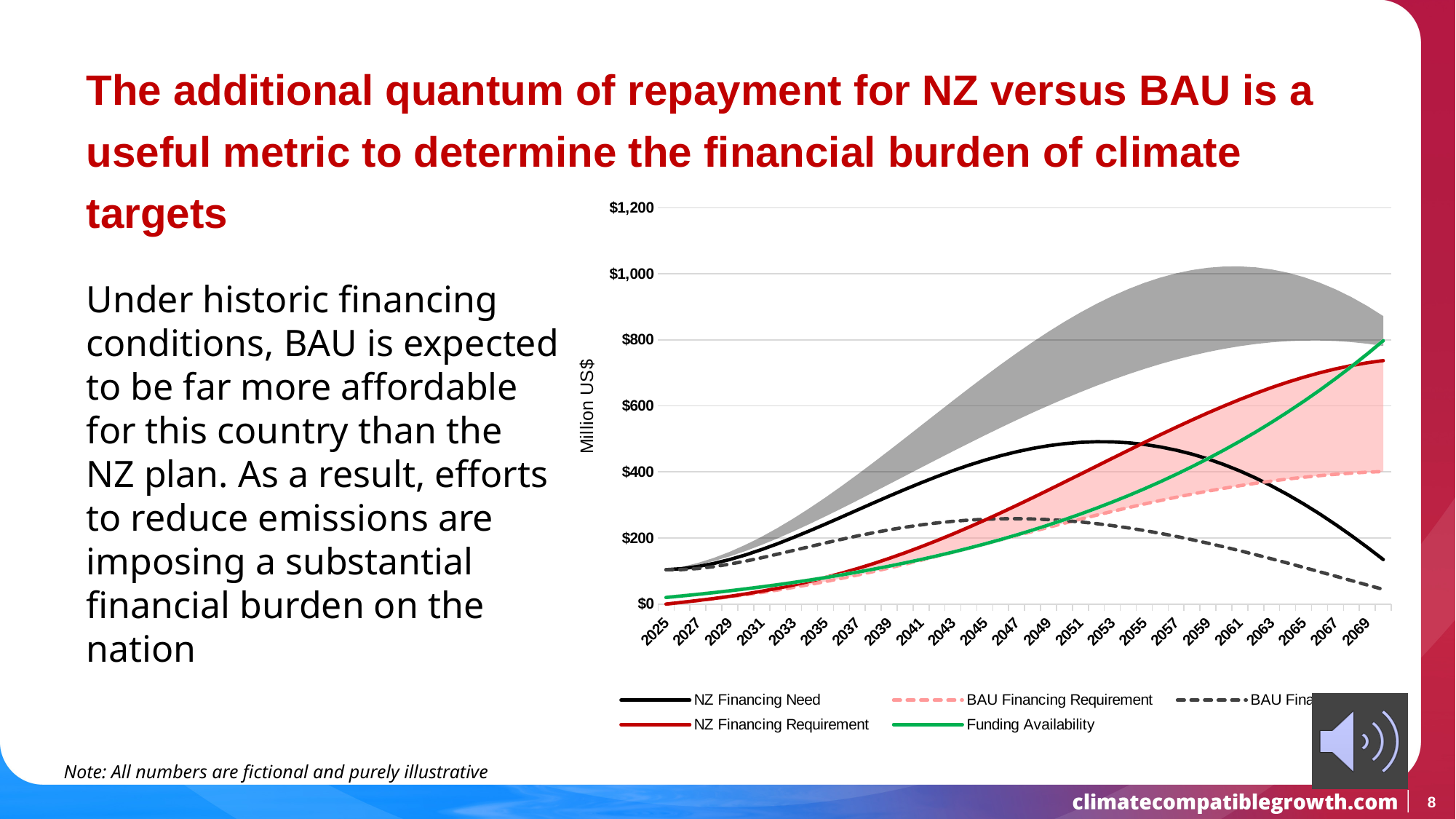
In 2069, which is larger: NZ Financing Requirement or BAU Financing Requirement? NZ Financing Requirement What kind of chart is shown on the slide? line chart Does the NZ Financing Need line rise or fall from 2053 to 2069? fall Is the value of NZ Financing Need in 2053 greater or less than $400? greater Is the value of NZ Financing Requirement in 2049 greater or less than $200? greater What is the highest value labelled on the vertical axis of the chart? $1,200 What is the title of the vertical axis of the chart? Million US$ In 2025, which is larger: NZ Financing Need or Funding Availability? NZ Financing Need Is the value of Funding Availability in 2025 greater or less than $200? less Does the Funding Availability line rise or fall from 2025 to 2069? rise